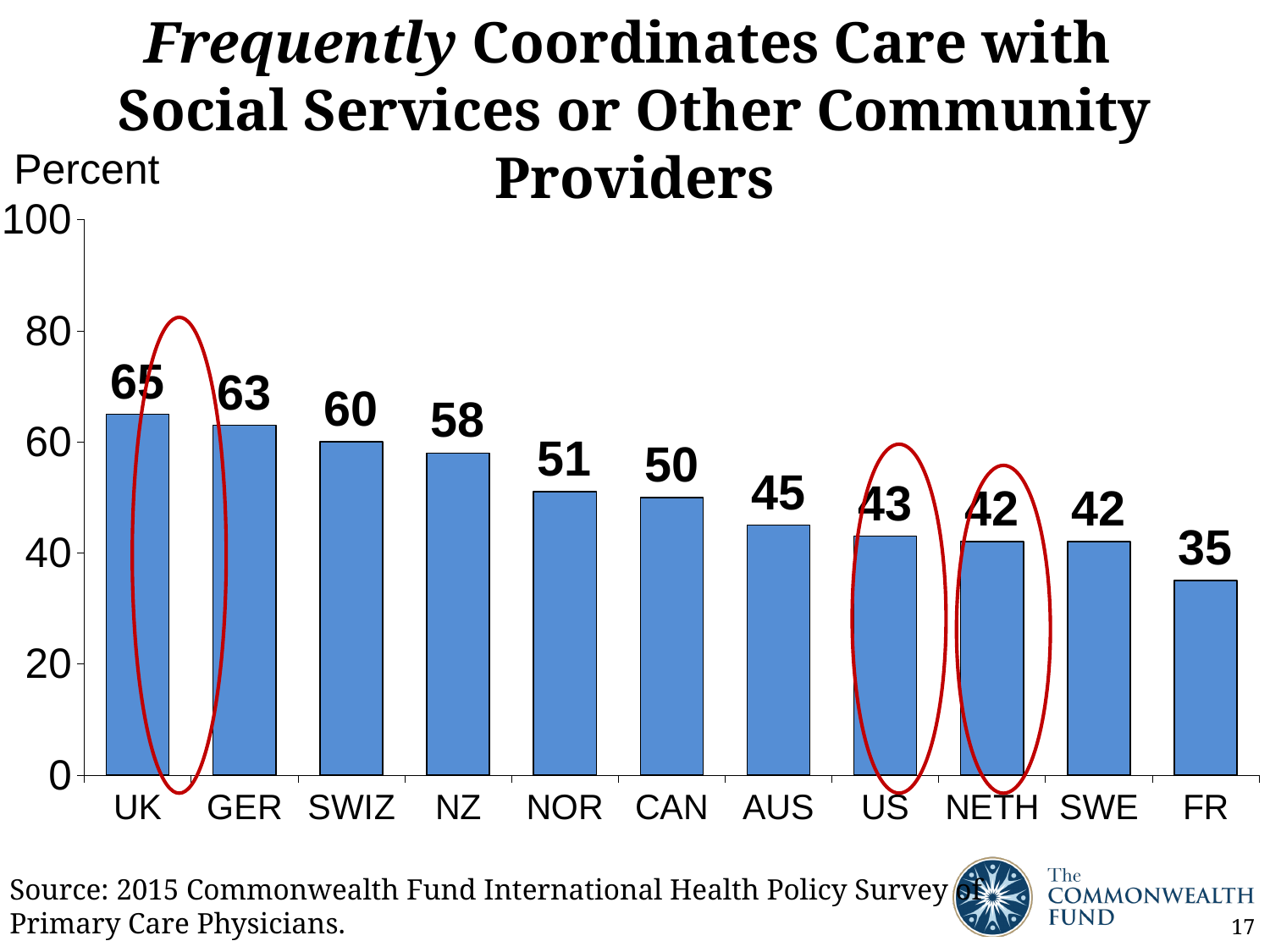
What is the value for the US? 43 What is the difference between the values for the UK and FR? 30 Is the value for AUS greater or less than 40? greater What is the difference between the values for GER and NETH? 21 Which is larger, the value for SWIZ or the value for NOR? SWIZ How many countries are shown in the chart? 11 What kind of chart is shown on the slide? bar chart What is the value for CAN? 50 What is the value for the UK? 65 Which country has the highest value? UK Which country has the lowest value? FR Do the values rise or fall from left to right along the x axis? fall